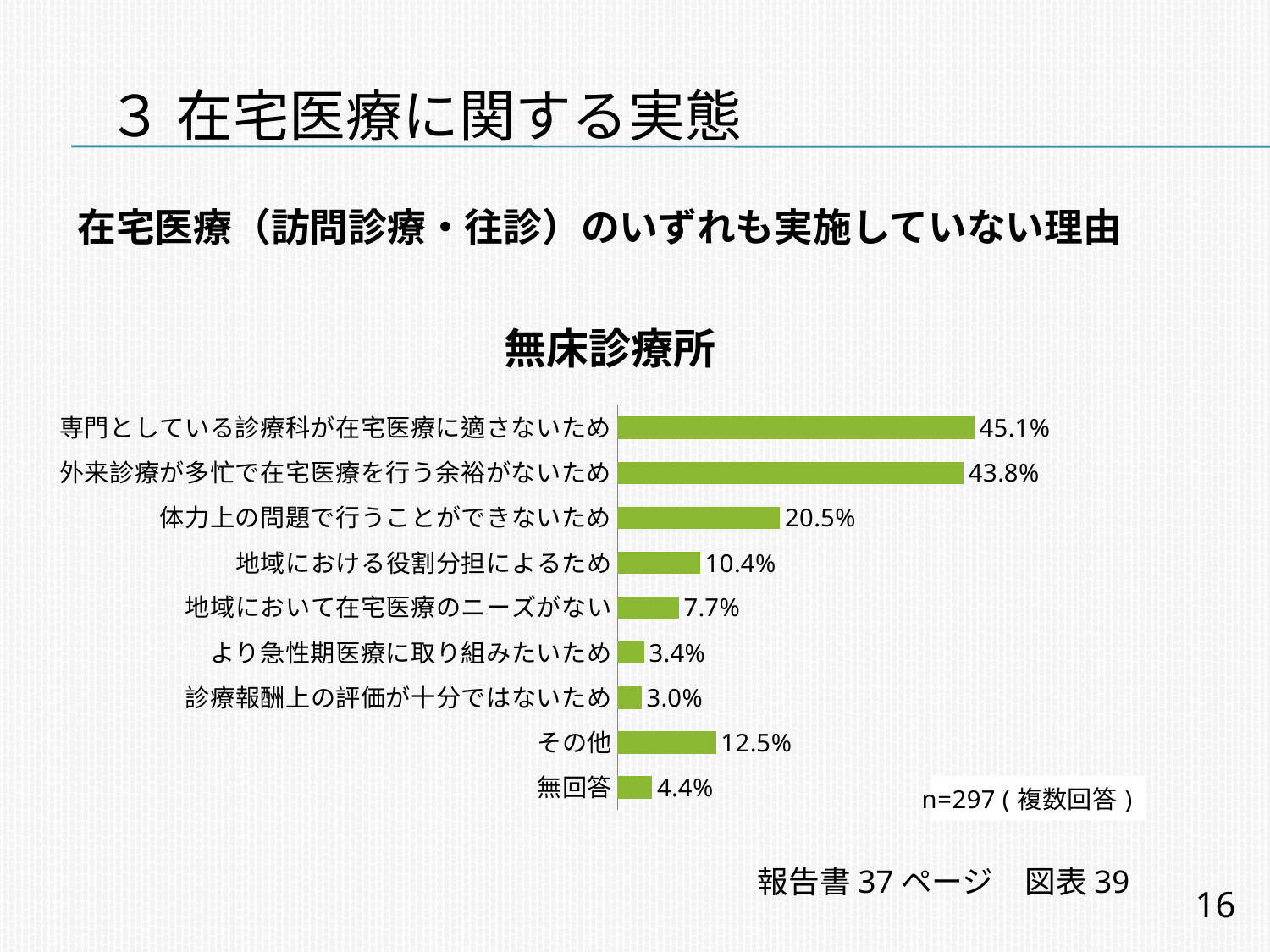
What is the sample size (n) shown on the chart? n=297 What is the value for 体力上の問題で行うことができないため? 20.5% What kind of chart is shown on the slide? bar chart Which is larger, 地域において在宅医療のニーズがない or その他? その他 What is the value for 無回答? 4.4% How many categories are shown in the chart? 9 What is the difference between 専門としている診療科が在宅医療に適さないため and 外来診療が多忙で在宅医療を行う余裕がないため? 1.3% What is the title of the chart? 無床診療所 What is the difference between その他 and 地域における役割分担によるため? 2.1% Which category has the highest value? 専門としている診療科が在宅医療に適さないため What is the value for 専門としている診療科が在宅医療に適さないため? 45.1% Which category has the lowest value? 診療報酬上の評価が十分ではないため